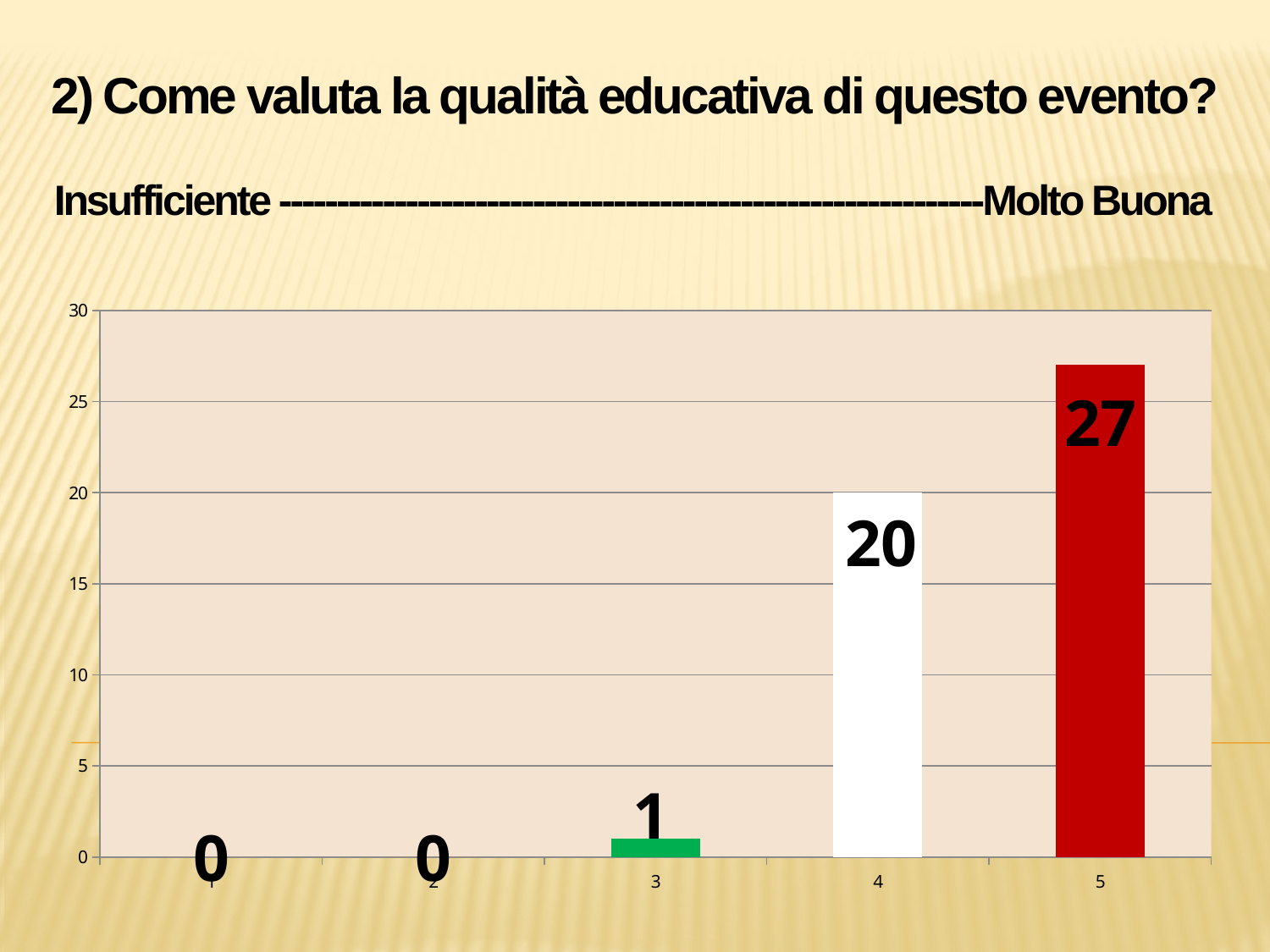
What is the value for category 1? 0 What is the value for category 3? 1 What colour is the bar for category 5? red What kind of chart is shown on the slide? bar chart What is the difference between the values for categories 5 and 4? 7 Which is larger, the value for category 3 or the value for category 4? 4 How many categories are shown on the x axis? 5 Do the values rise or fall from category 1 to category 5? rise Which category has the highest value? 5 What is the value for category 4? 20 What is the value for category 5? 27 Is the value for category 5 greater or less than 25? greater